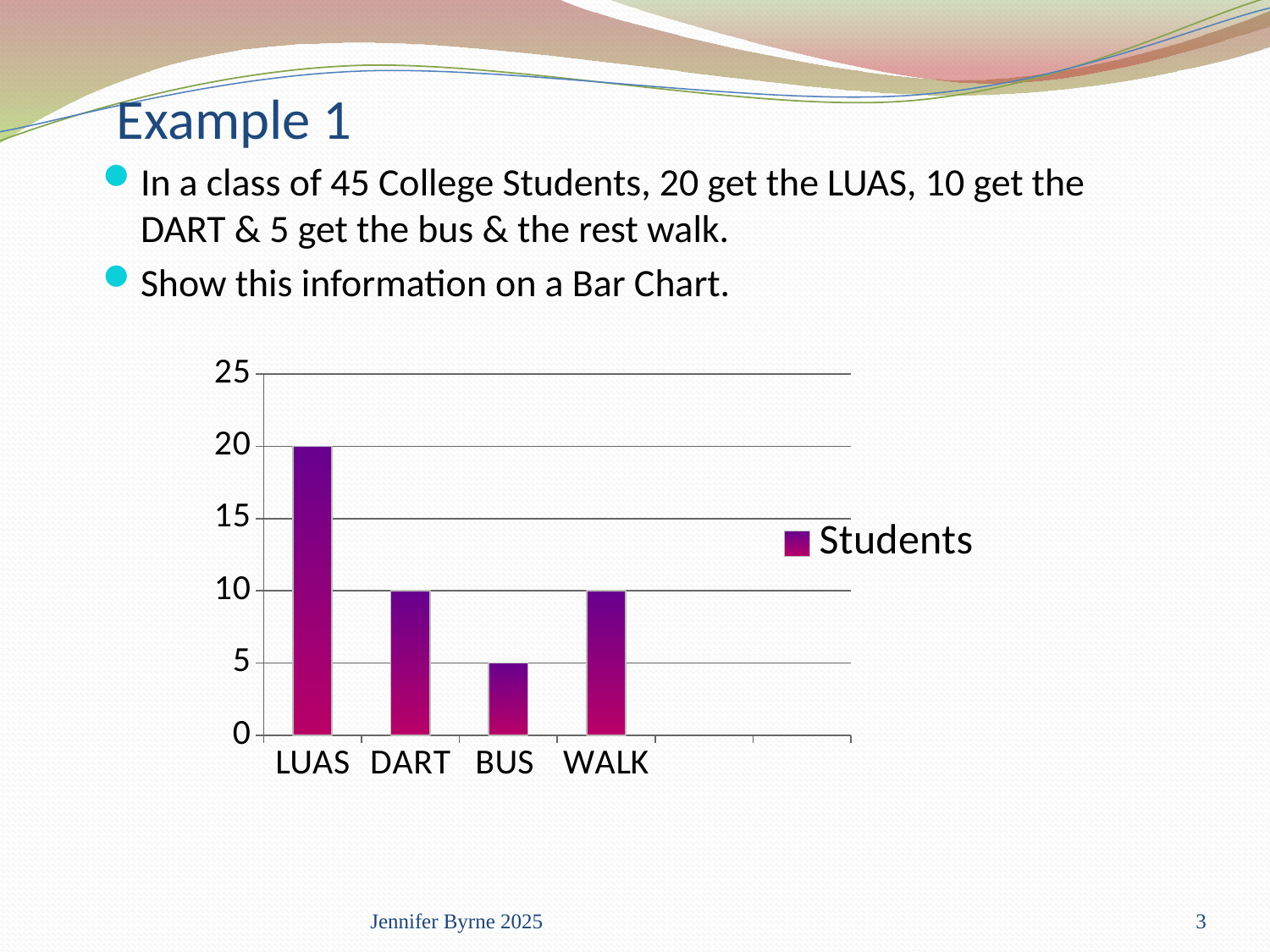
What is the value for BUS in the chart? 5 How many categories are shown on the x axis of the chart? 4 Which category has the highest value in the chart? LUAS What is the value for DART in the chart? 10 What is the name of the series shown in the chart legend? Students What type of chart is shown on the slide? bar chart Which is larger, the value for LUAS or the value for WALK? LUAS Which category has the lowest value in the chart? BUS What is the difference between the values for LUAS and BUS? 15 How many series does the chart legend list? 1 What is the value for LUAS in the chart? 20 Is the value for LUAS greater or less than 15? greater